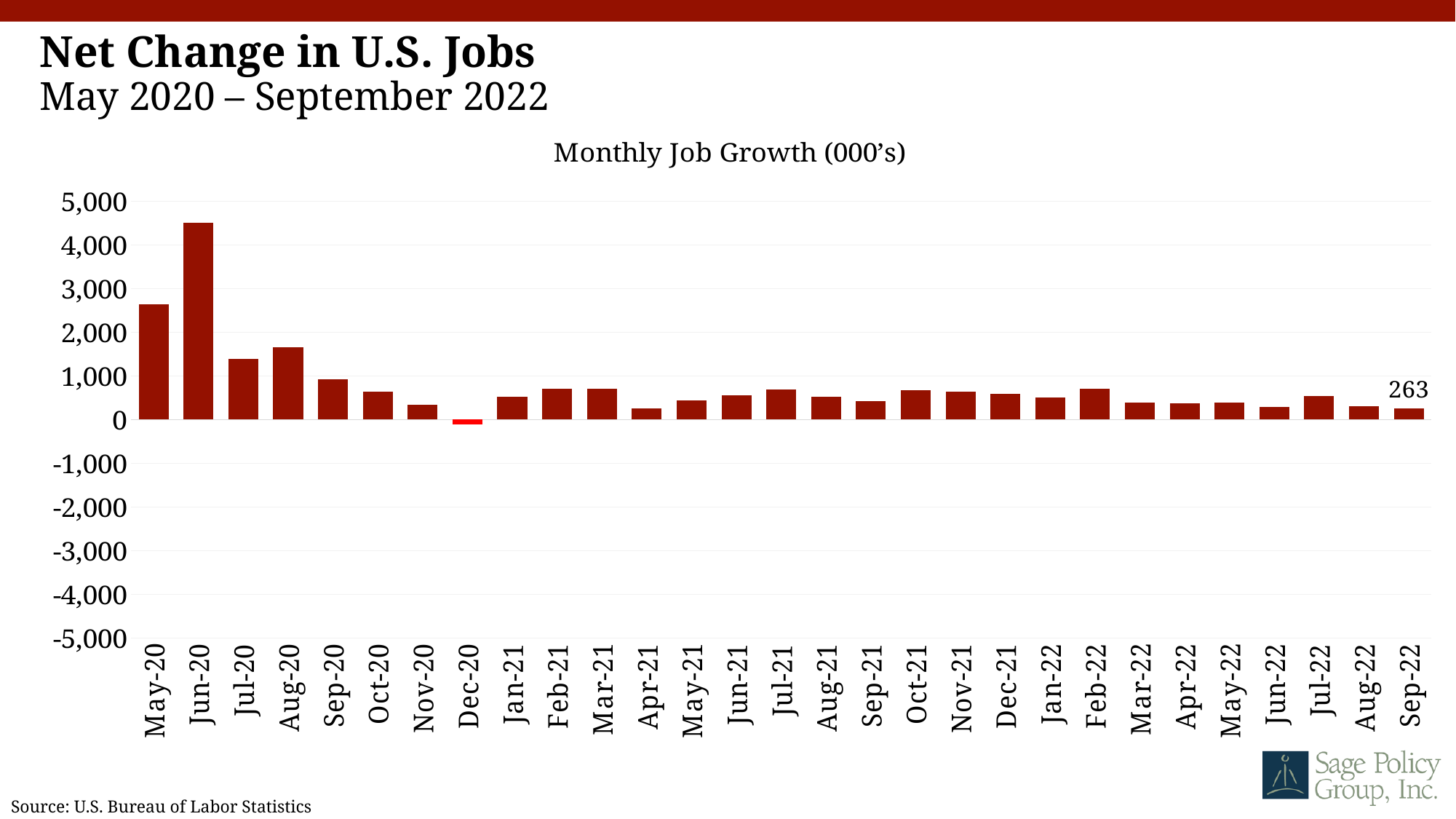
Is the value for Oct-20 greater or less than 1,000? less Do the monthly job growth values generally rise or fall from May-20 to Sep-22? fall Is the value for Dec-20 greater or less than 0? less What is the title shown above the chart's plot area? Monthly Job Growth (000's) Is the value for Jun-20 greater or less than 4,000? greater How many months are plotted on the chart? 29 What kind of chart is shown on the slide? bar chart Which month has the lowest monthly job growth? Dec-20 Which is larger, the value for Aug-20 or the value for Jul-20? Aug-20 Which month has the highest monthly job growth? Jun-20 What is the value for Sep-22? 263